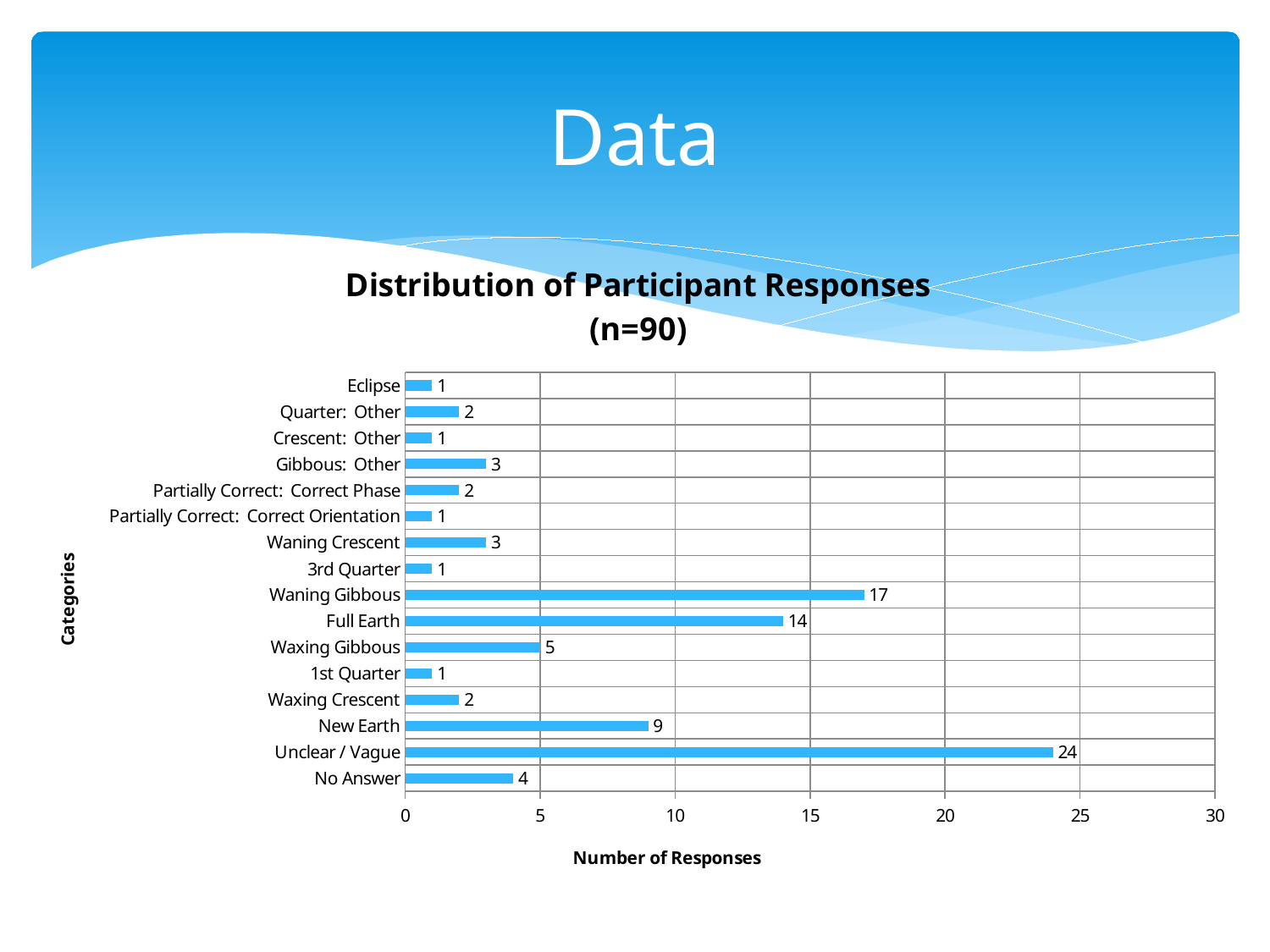
Which has more responses, New Earth or Waxing Gibbous? New Earth How many categories are shown on the chart? 16 What is the number of responses for No Answer? 4 What is the title of the chart? Distribution of Participant Responses (n=90) Is the value for Unclear / Vague greater or less than 20? greater What is the number of responses for Waning Gibbous? 17 What is the difference in responses between Full Earth and Waxing Gibbous? 9 What is the number of responses for New Earth? 9 What is the difference in responses between Unclear / Vague and Waning Gibbous? 7 What kind of chart is shown on the slide? Bar chart What is the number of responses for Full Earth? 14 Which category has the highest number of responses? Unclear / Vague